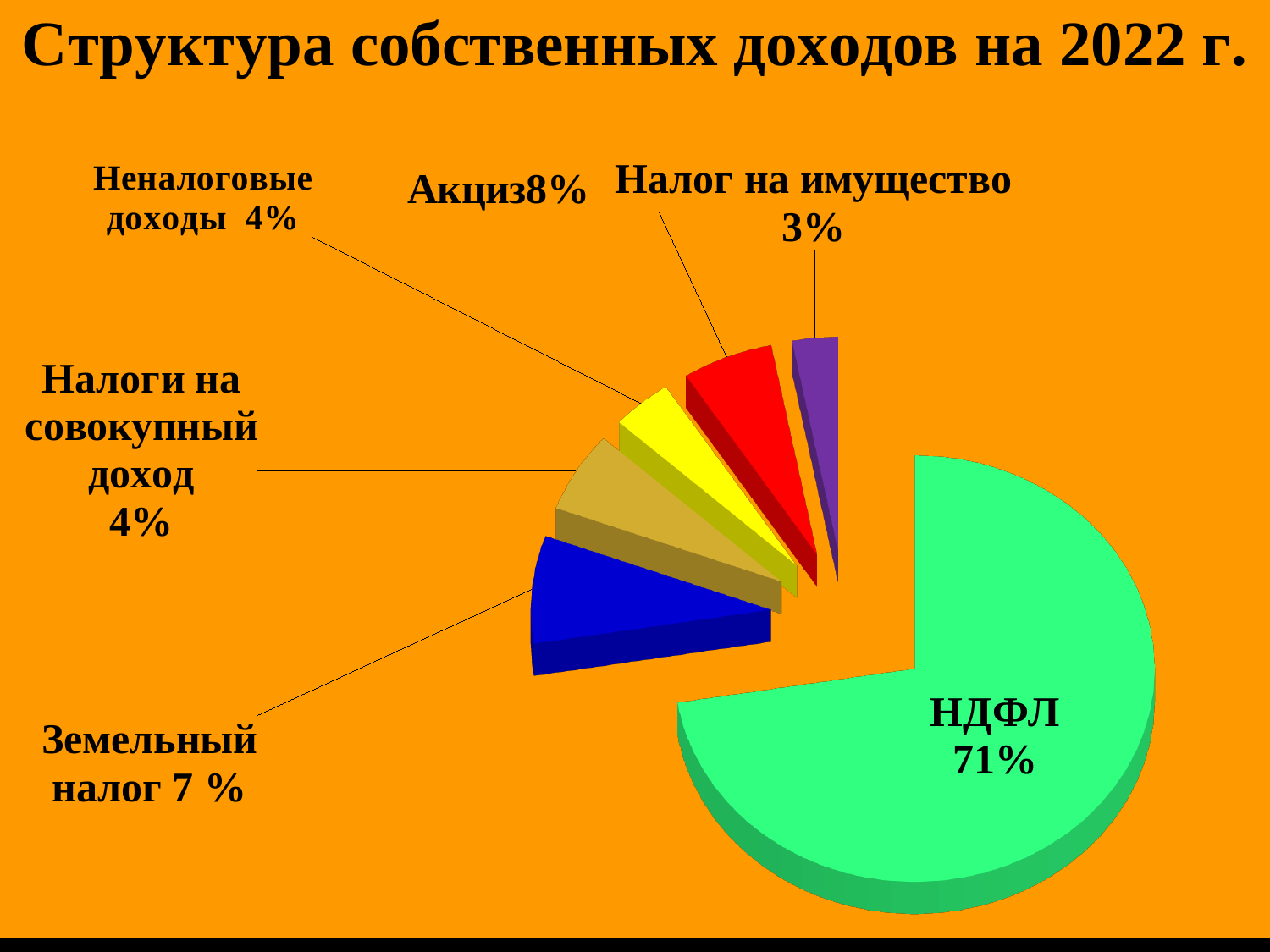
What is the difference in percentage points between НДФЛ and Земельный налог? 64 What is the value shown for Земельный налог? 7 % What is the value shown for Неналоговые доходы? 4% What is the title of the chart? Структура собственных доходов на 2022 г. What is the value shown for Акциз? 8% What is the value shown for Налог на имущество? 3% Which is larger, Акциз or Земельный налог? Акциз How many slices does the pie chart have? 6 Which category has the smallest slice of the pie? Налог на имущество What kind of chart is shown on the slide? pie chart Which category has the largest slice of the pie? НДФЛ What share of the pie does НДФЛ have? 71%